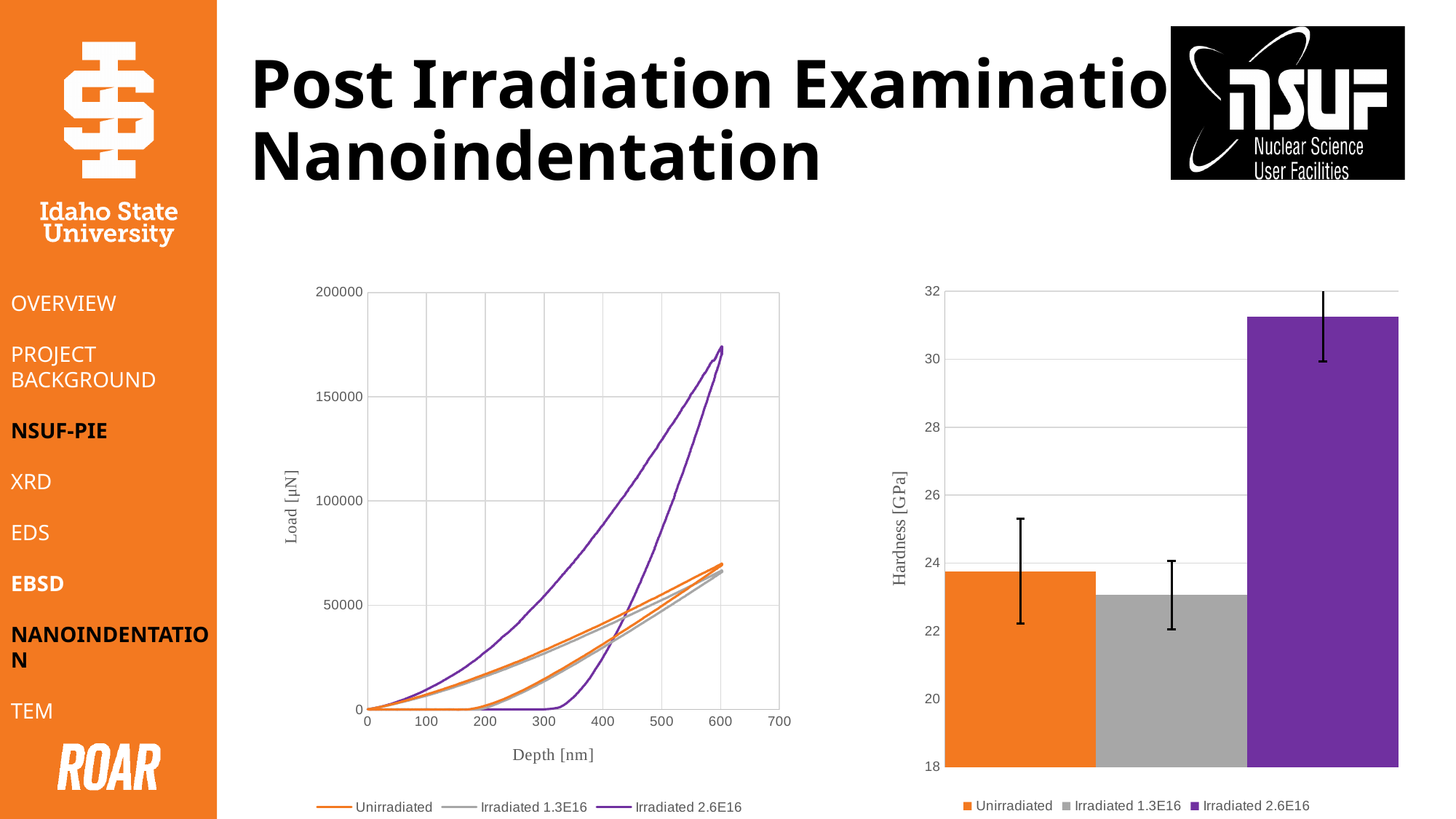
What kind of chart is the left-hand chart (Load vs Depth)? line chart On the left-hand chart (Load vs Depth), is the peak load for Irradiated 2.6E16 greater or less than 150000? greater On the left-hand chart (Load vs Depth), what is the label of the x axis? Depth [nm] On the right-hand chart (Hardness [GPa]), which is larger: the hardness for Unirradiated or for Irradiated 1.3E16? Unirradiated What kind of chart is the right-hand chart (Hardness [GPa])? bar chart On the right-hand chart (Hardness [GPa]), is the hardness for Irradiated 2.6E16 greater or less than 30? greater On the right-hand chart (Hardness [GPa]), is the hardness for Irradiated 1.3E16 greater or less than 22? greater On the right-hand chart (Hardness [GPa]), which category has the highest hardness? Irradiated 2.6E16 On the left-hand chart (Load vs Depth), how many series does the legend list? 3 On the left-hand chart (Load vs Depth), which series reaches the highest load? Irradiated 2.6E16 On the right-hand chart (Hardness [GPa]), how many bars are plotted? 3